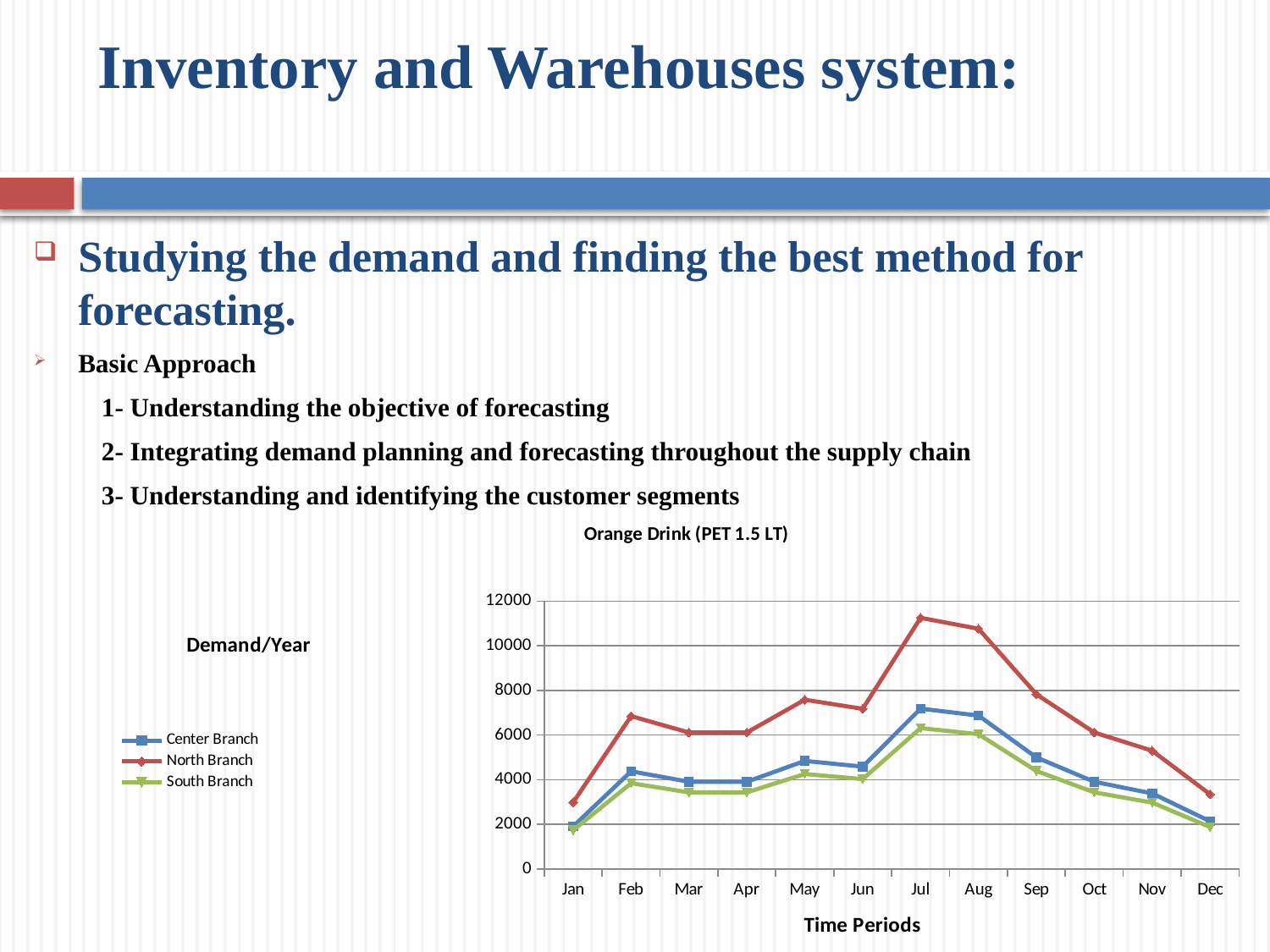
In which month does the Center Branch reach its highest value? Jul In which month is the North Branch value lowest? Jan What is the title of the chart? Orange Drink (PET 1.5 LT) How many series does the chart legend list? 3 Is the North Branch value for Jul greater or less than 10000? greater How many time periods are plotted along the x axis? 12 Is the South Branch value for Jan greater or less than 2000? less What is the label of the x axis? Time Periods Which is larger in Jul, the North Branch value or the Center Branch value? North Branch Do the North Branch values rise or fall from Jul to Dec? fall In which month does the North Branch reach its highest value? Jul What kind of chart is shown on the slide? line chart